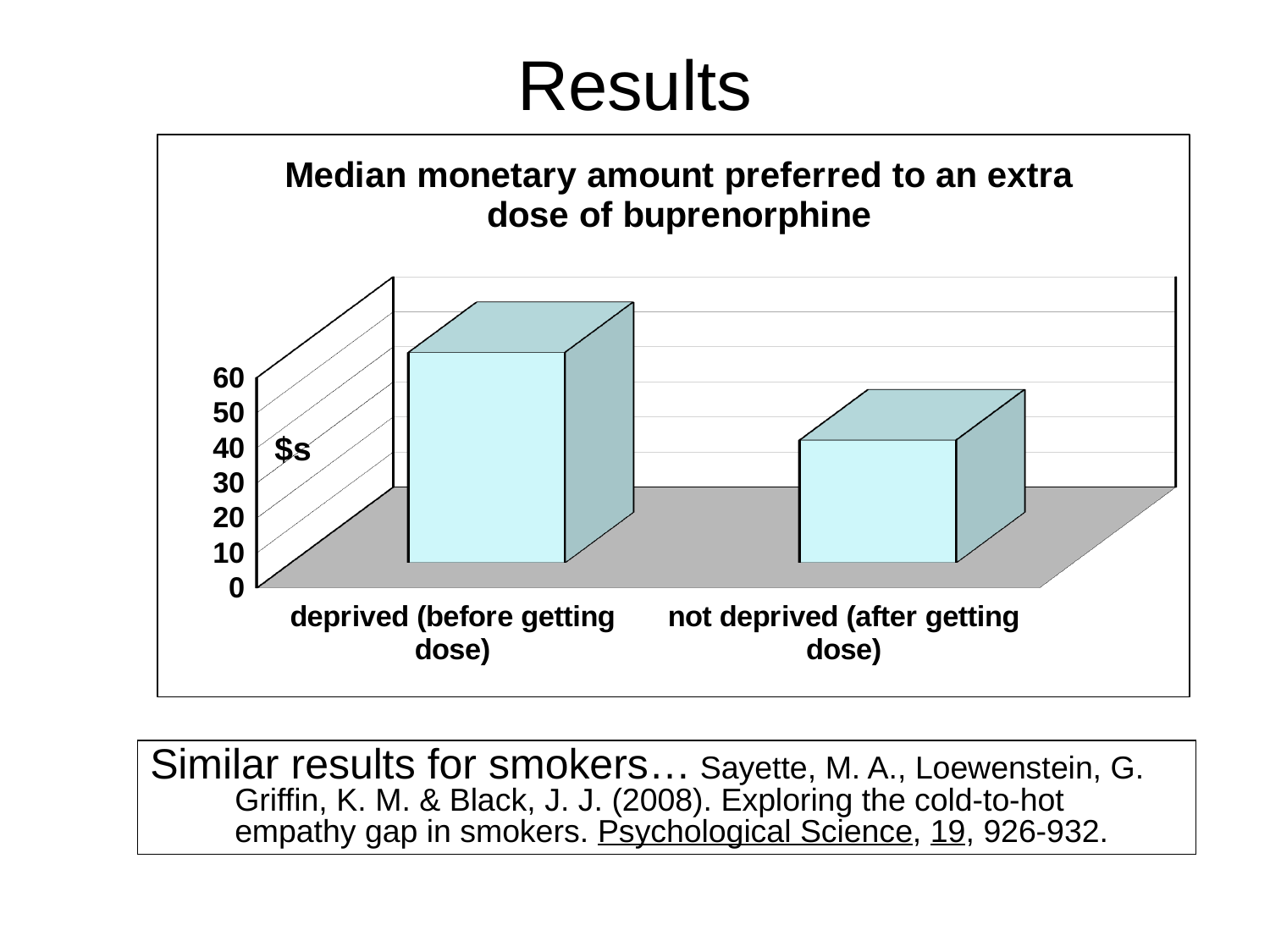
Do the bar values rise or fall from the left category to the right category? fall What unit label is shown on the vertical axis of the chart? $s Which category has the lowest bar? not deprived (after getting dose) Which category has the highest bar? deprived (before getting dose) Is the value for not deprived (after getting dose) greater or less than 20? greater Which is larger, the value for deprived (before getting dose) or for not deprived (after getting dose)? deprived (before getting dose) What is the title of the chart? Median monetary amount preferred to an extra dose of buprenorphine Is the value for not deprived (after getting dose) greater or less than 50? less What kind of chart is shown on the slide? bar chart Is the value for deprived (before getting dose) greater or less than 40? greater How many categories are plotted in the chart? 2